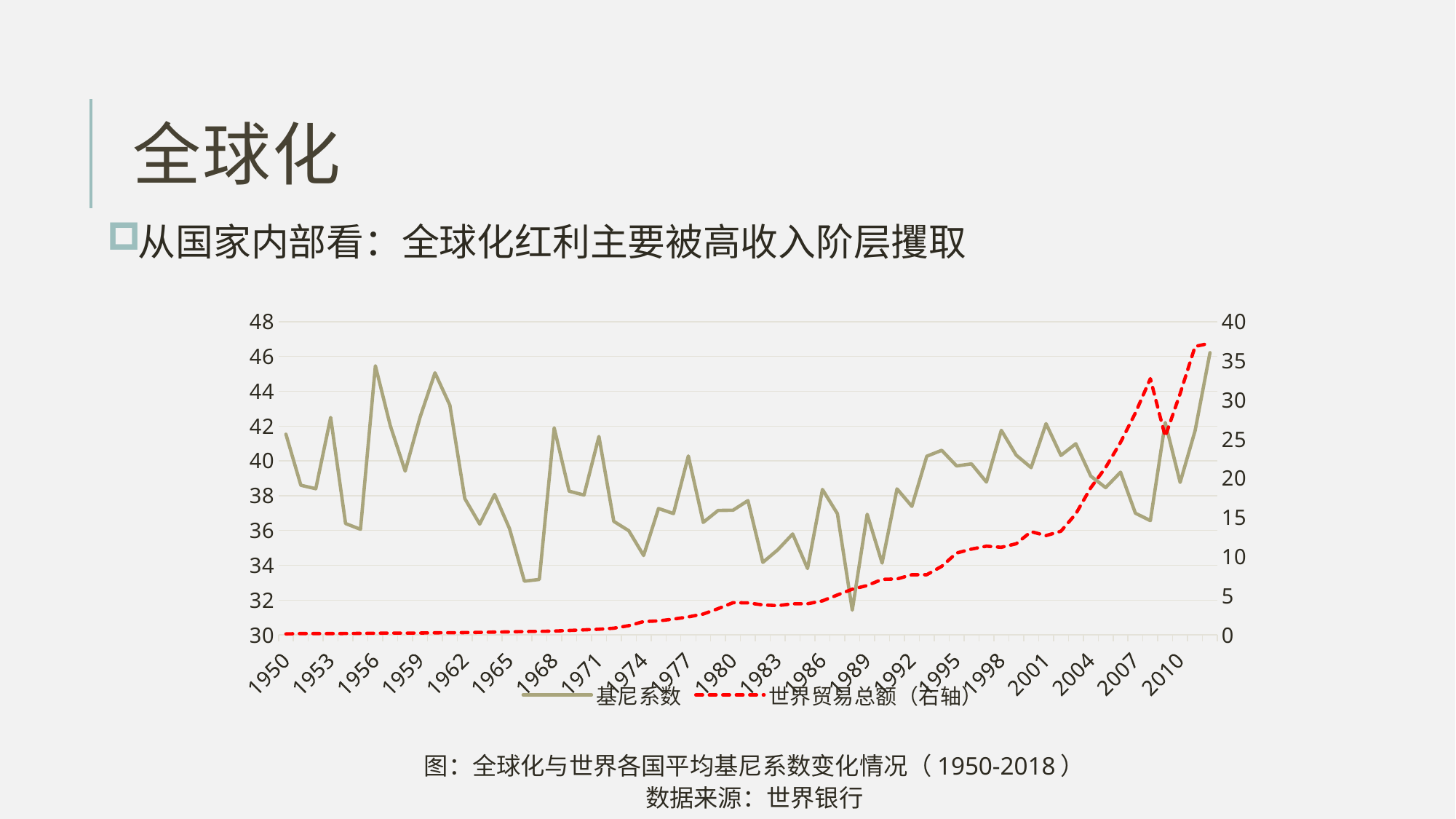
Does the 世界贸易总额 (world trade) series generally rise or fall from 1950 to the end of the period? rise What is the highest tick value shown on the left vertical axis? 48 Is the 世界贸易总额 value at the end of the series greater or less than 35 on the right axis? greater Is the 基尼系数 value in 1950 greater or less than 40? greater Is the 世界贸易总额 value in 1950 greater or less than 5 on the right axis? less Which series is drawn as a red dashed line? 世界贸易总额（右轴） What kind of chart is shown on the slide? line chart Which axis does the 世界贸易总额 series use, according to the legend? 右轴 (right axis) How many series does the chart legend list? 2 What is the first year label shown on the x axis? 1950